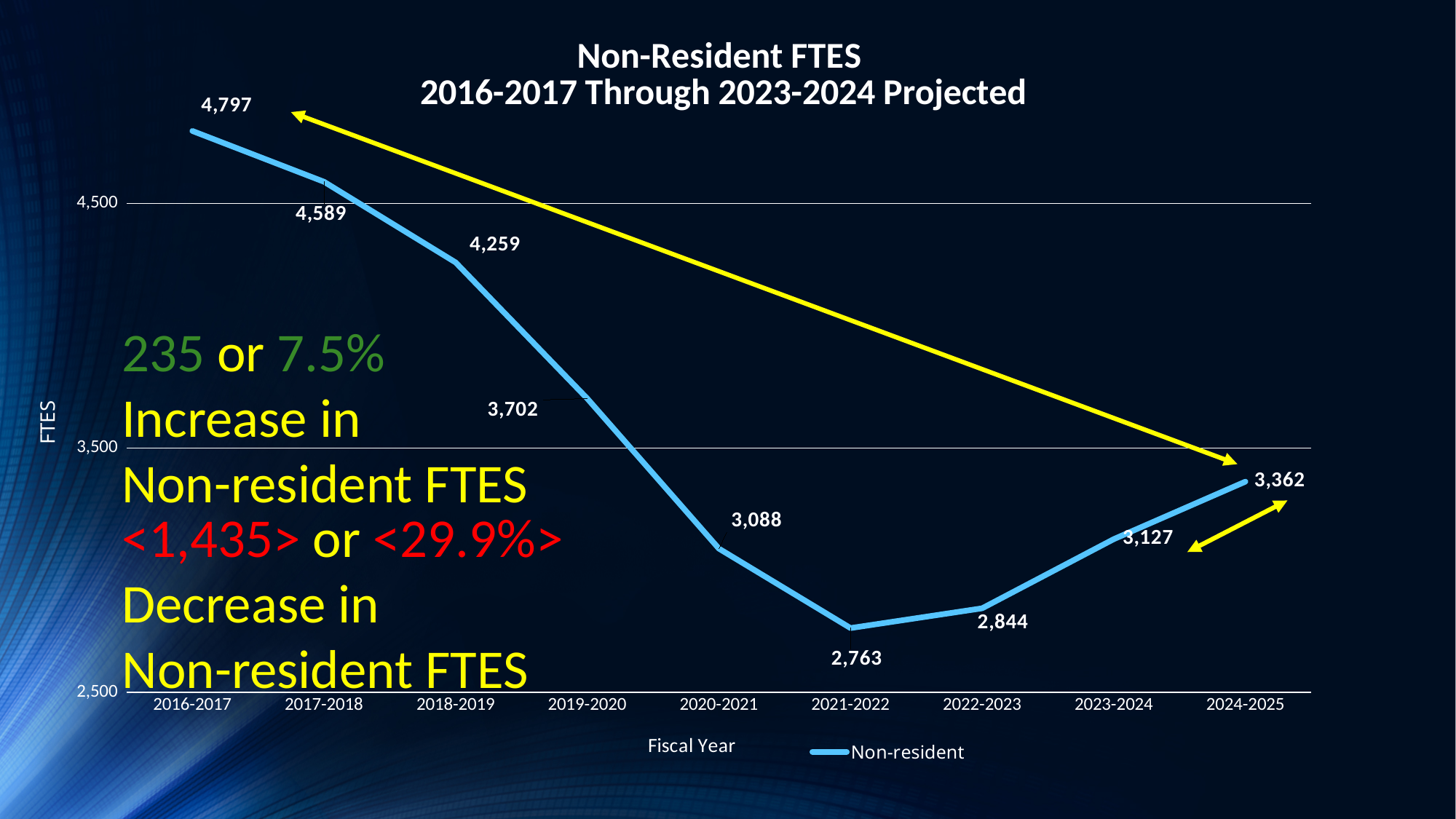
What is the Non-resident FTES value for 2016-2017? 4,797 Which fiscal year has the lowest Non-resident FTES value? 2021-2022 Which fiscal year has the highest Non-resident FTES value? 2016-2017 Is the Non-resident FTES value for 2018-2019 greater or less than 4,500? less What is the Non-resident FTES value for 2024-2025? 3,362 Which is larger, the Non-resident FTES value for 2019-2020 or for 2023-2024? 2019-2020 How many fiscal years are plotted on the x axis? 9 What is the Non-resident FTES value for 2021-2022? 2,763 How many series does the legend list? 1 What is the difference between the Non-resident FTES values for 2016-2017 and 2021-2022? 2,034 What type of chart is shown on the slide? Line chart Do the Non-resident FTES values rise or fall from 2016-2017 to 2021-2022? Fall